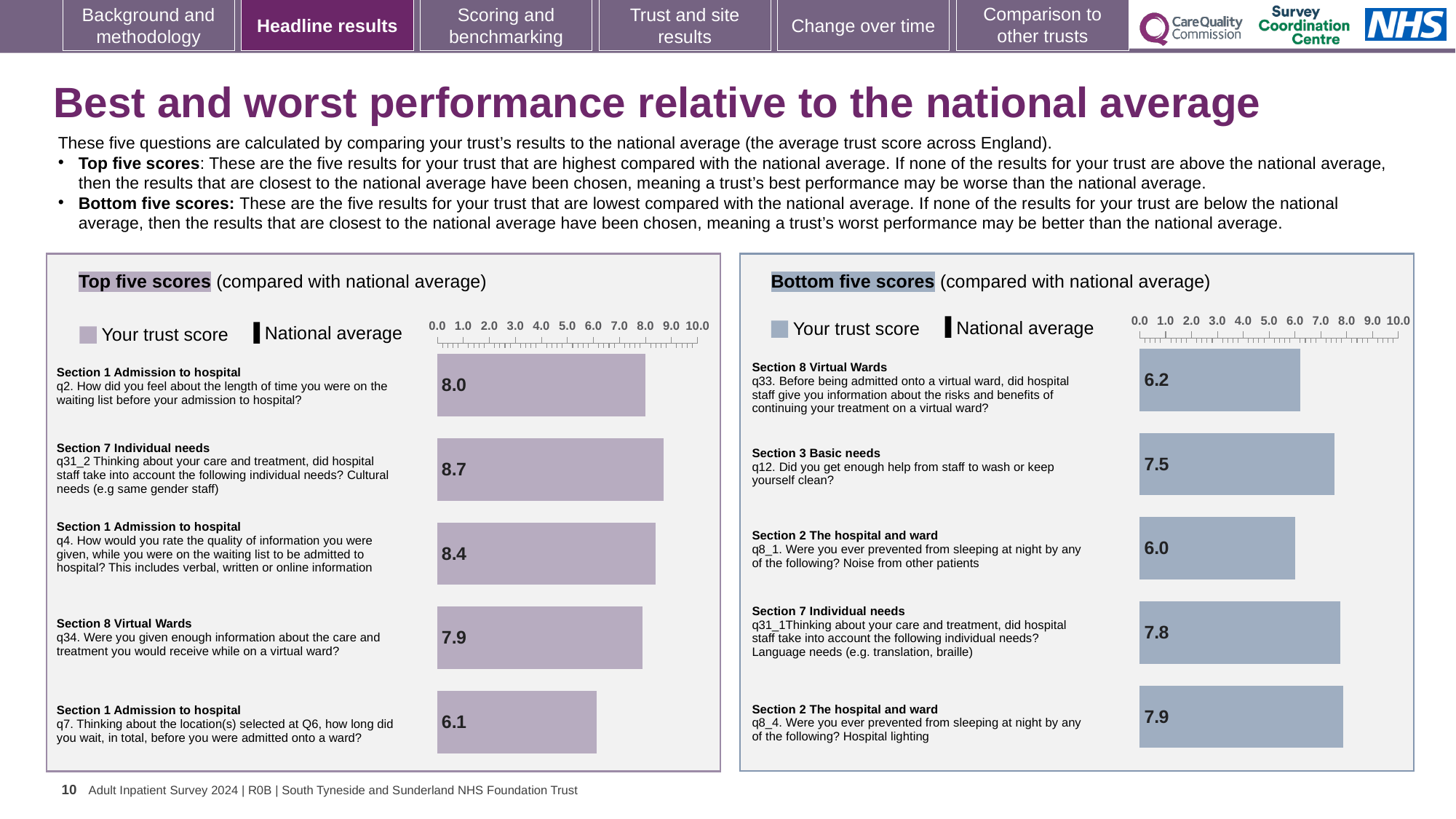
In the Top five scores chart, which question has the highest trust score? q31_2 (cultural needs) In the Top five scores chart, what is the trust score for q31_2 (cultural needs)? 8.7 In the Top five scores chart, what is the trust score for q2 (length of time on the waiting list before admission)? 8.0 What type of chart is used for the Bottom five scores? Bar chart How many bars are plotted in the Top five scores chart? 5 In the Bottom five scores chart, what is the trust score for q8_4 (hospital lighting)? 7.9 In the Top five scores chart, what is the difference between the trust scores for q31_2 and q7? 2.6 In the Bottom five scores chart, which question has the lowest trust score? q8_1 (noise from other patients) In the Bottom five scores chart, which is larger: the trust score for q33 or for q31_1? q31_1 In the Bottom five scores chart, what is the difference between the trust scores for q8_4 and q8_1? 1.9 In the Bottom five scores chart, what is the trust score for q12 (enough help from staff to wash or keep yourself clean)? 7.5 In the Top five scores chart, which question has the lowest trust score? q7 (how long you waited before being admitted onto a ward)